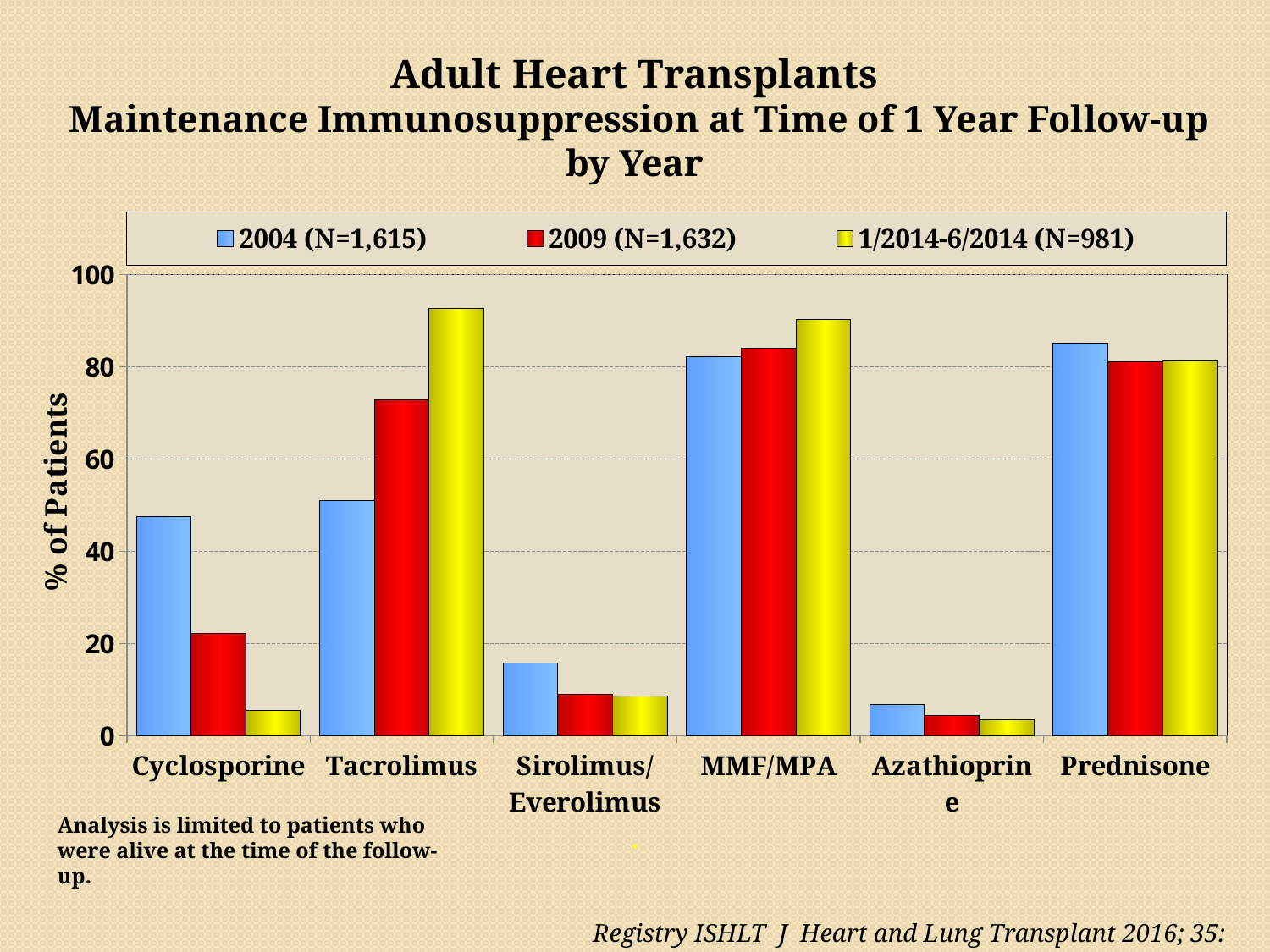
Do the values for Cyclosporine rise or fall from 2004 to 1/2014-6/2014? fall How many series does the legend list? 3 What kind of chart is shown on the slide? Bar chart How many drug categories are shown on the x axis? 6 What is the N shown in the legend for the 2009 series? N=1,632 Is the value for Cyclosporine in 1/2014-6/2014 greater or less than 20? less Which drug category has the lowest value for 2009? Azathioprine Is the value for Tacrolimus in 1/2014-6/2014 greater or less than 80? greater Do the values for Tacrolimus rise or fall from 2004 to 1/2014-6/2014? rise Is the value for Cyclosporine in 2004 greater or less than 40? greater For Cyclosporine, which is larger: the 2004 value or the 2009 value? 2004 For 1/2014-6/2014, which is larger: Tacrolimus or Cyclosporine? Tacrolimus